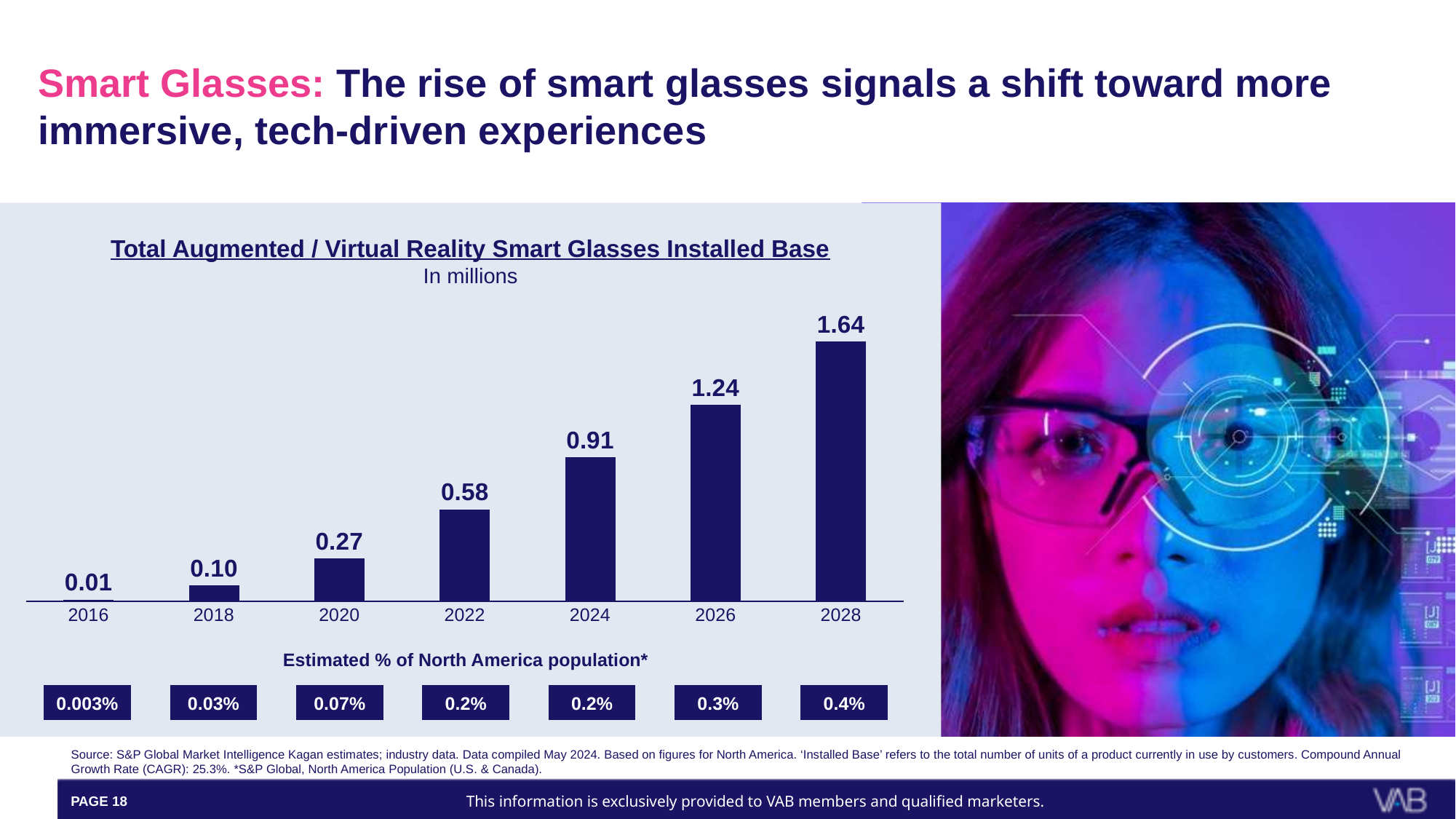
What is the installed base value shown for 2016? 0.01 How many years are plotted on the chart? 7 Which year has a larger installed base value, 2020 or 2024? 2024 What is the installed base value shown for 2028? 1.64 What is the difference between the installed base values for 2028 and 2026? 0.40 Do the installed base values rise or fall from 2016 to 2028? Rise What is the estimated % of North America population shown below the 2026 bar? 0.3% What unit is the chart's installed base measured in, according to the subtitle? In millions Which year has the highest installed base value? 2028 What is the installed base value shown for 2022? 0.58 Which year has the lowest installed base value? 2016 What kind of chart is used to show the installed base? Bar chart